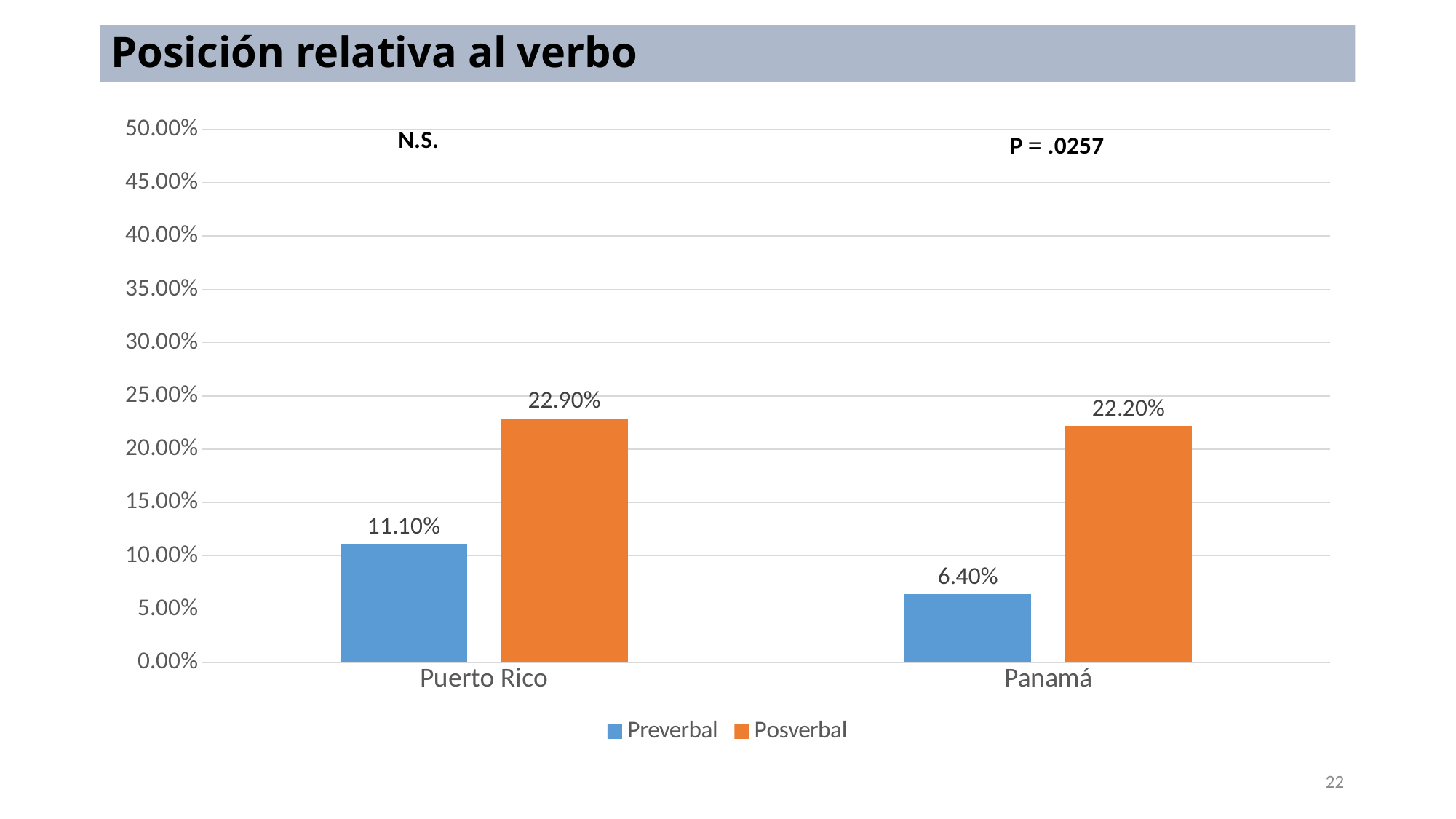
What is the Preverbal value for Panamá? 6.40% What kind of chart is shown on the slide? Bar chart How many series does the legend list? 2 Which is larger for Panamá, the Preverbal or the Posverbal value? Posverbal What is the Posverbal value for Panamá? 22.20% How many categories are shown on the x axis? 2 Which category has the lowest Preverbal value? Panamá What is the Posverbal value for Puerto Rico? 22.90% What is the difference between the Preverbal values for Puerto Rico and Panamá? 4.70% Which category has the highest Posverbal value? Puerto Rico What is the difference between the Posverbal and Preverbal values for Puerto Rico? 11.80% What is the Preverbal value for Puerto Rico? 11.10%